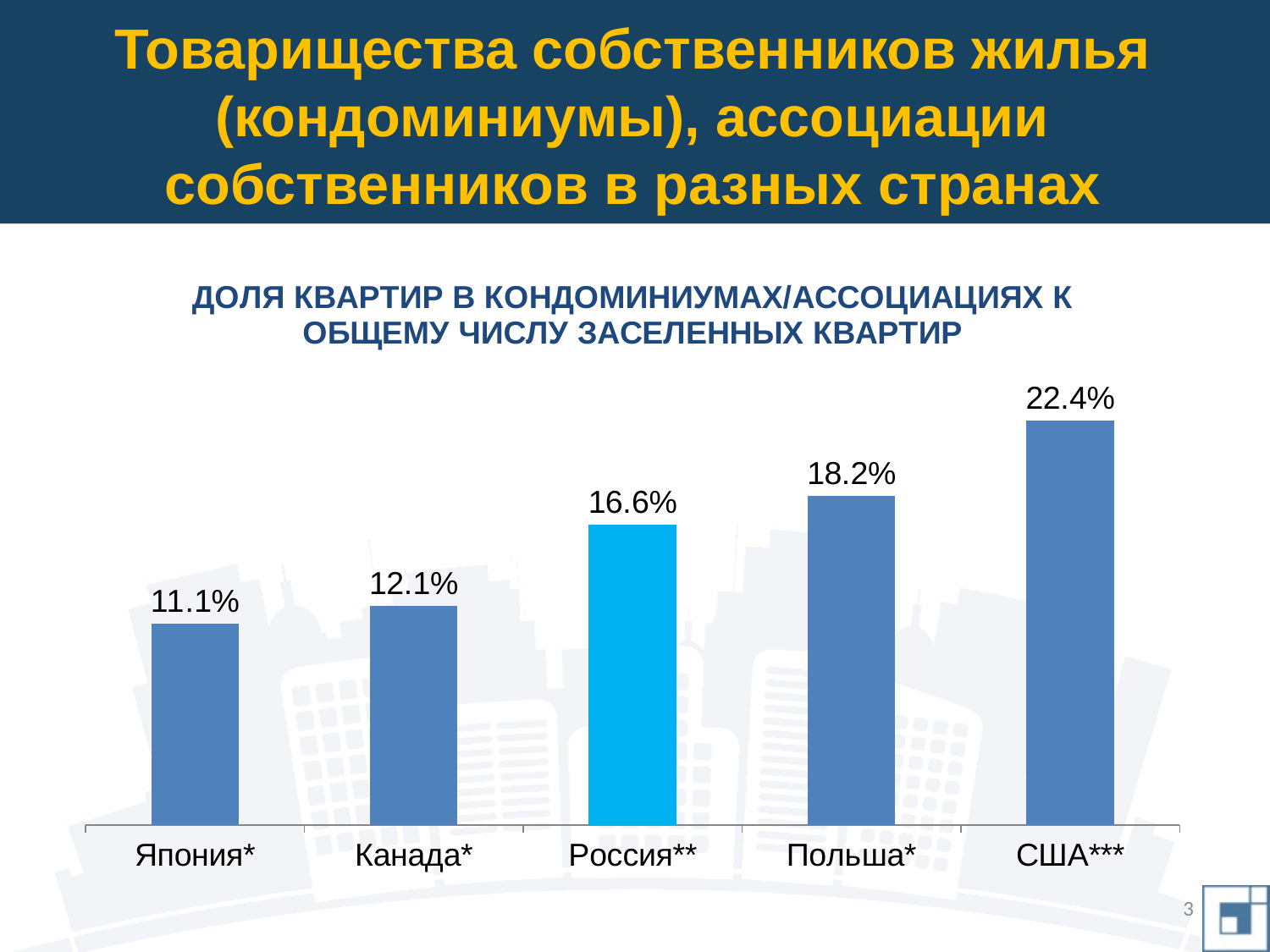
What is the value for Япония*? 11.1% Do the values rise or fall from left to right along the x axis? rise Which country has the lowest value? Япония* What kind of chart is shown on the slide? bar chart What is the value for Польша*? 18.2% Which is larger, the value for Канада* or the value for Россия**? Россия** Which country has the highest value? США*** How many countries are shown in the chart? 5 What is the difference between the values for Польша* and Россия**? 1.6% Which bar is highlighted in a different (lighter blue) colour? Россия** What is the difference between the values for США*** and Япония*? 11.3% What is the value for Россия**? 16.6%